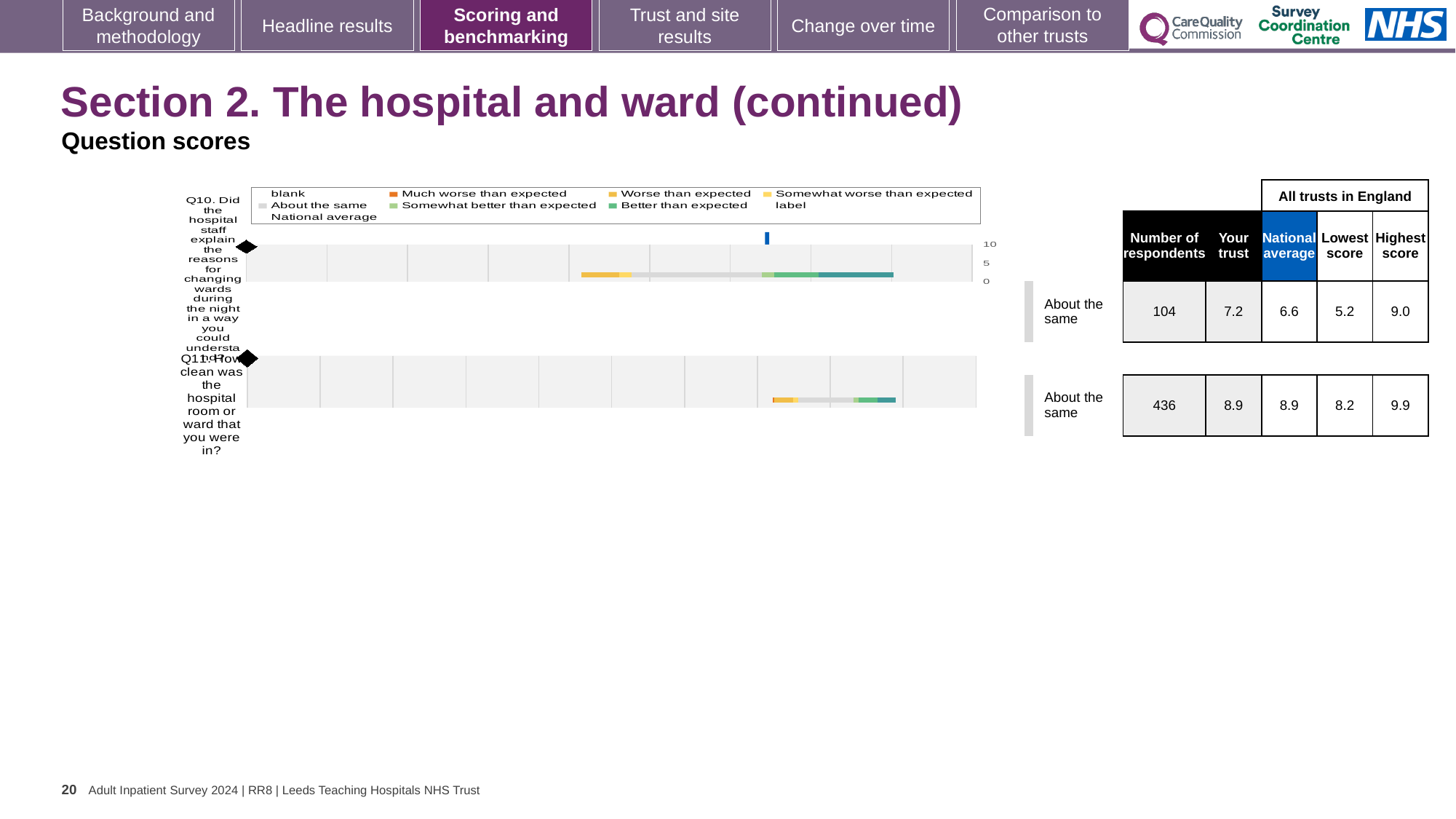
For Q11, how many respondents are shown? 436 How many questions (charts) are plotted on the slide? 2 For Q10 (explaining reasons for changing wards during the night), how many respondents are shown in the table? 104 For Q10, what is the difference between the 'Your trust' score and the national average? 0.6 How many entries does the legend above the Q10 chart list? 9 What kind of chart is used for the Q10 and Q11 question scores? bar chart For Q11 (how clean was the hospital room or ward), what is the national average score? 8.9 For Q10, what is the national average score? 6.6 For Q10, what is the 'Your trust' score? 7.2 For Q11, what is the difference between the highest score and the lowest score across all trusts in England? 1.7 For Q10, which is larger: the 'Your trust' score or the national average? Your trust What benchmark category label is shown next to the Q11 chart? About the same